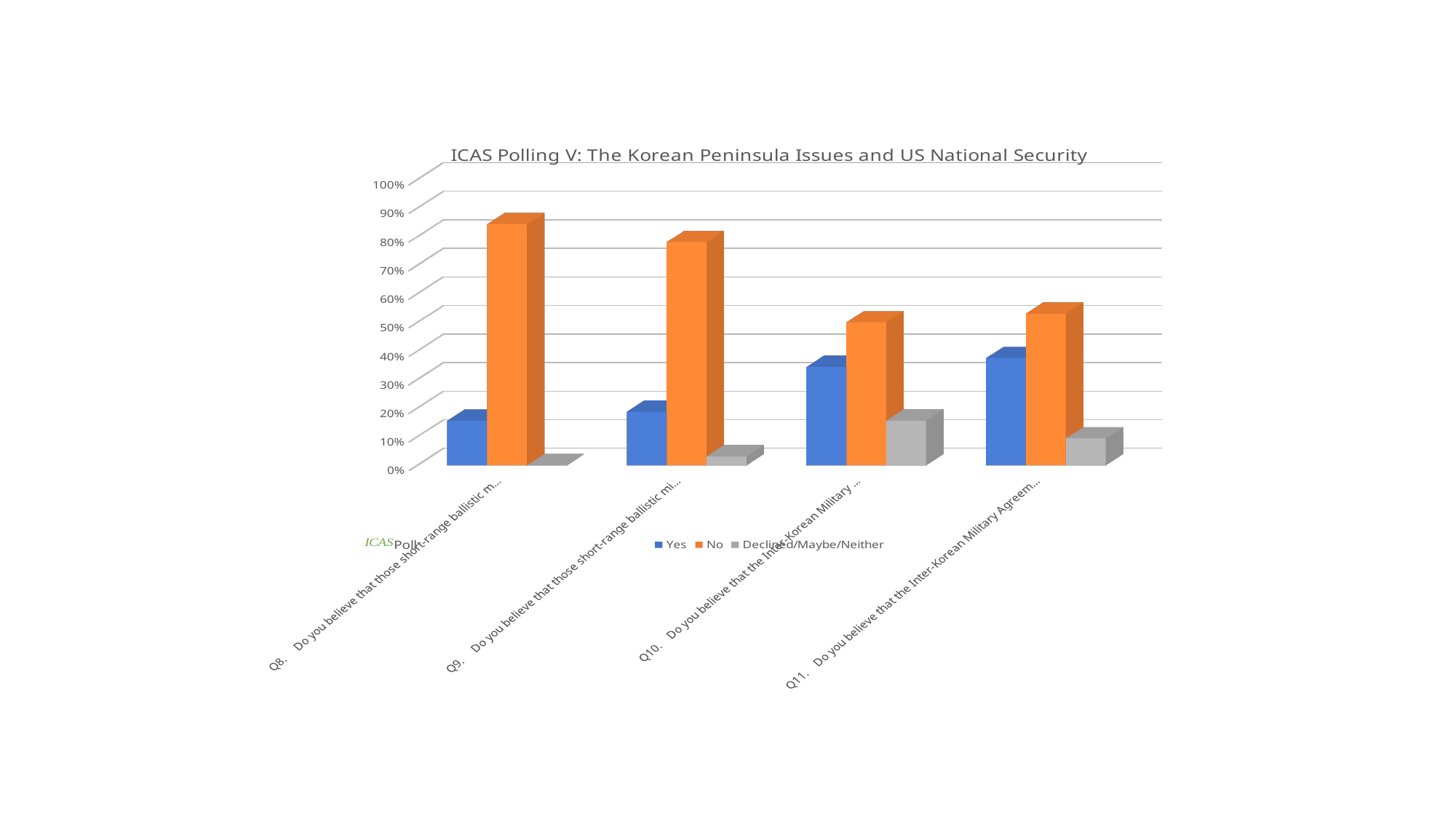
How many series does the legend list? 3 For which question is the "No" bar the highest? Q8 Which series is shown in orange in the legend? No Is the "No" value for Q8 greater or less than 80%? greater Is the "Yes" value for Q11 greater or less than 30%? greater Is the "Yes" value for Q8 greater or less than 20%? less For which question is the "Yes" bar the lowest? Q8 Which is larger, the "Yes" value for Q10 or the "Yes" value for Q8? Q10 How many question categories are plotted along the x axis? 4 What is the title of the chart? ICAS Polling V: The Korean Peninsula Issues and US National Security What kind of chart is shown on the slide? bar chart Which is larger, the "No" value for Q8 or the "No" value for Q9? Q8